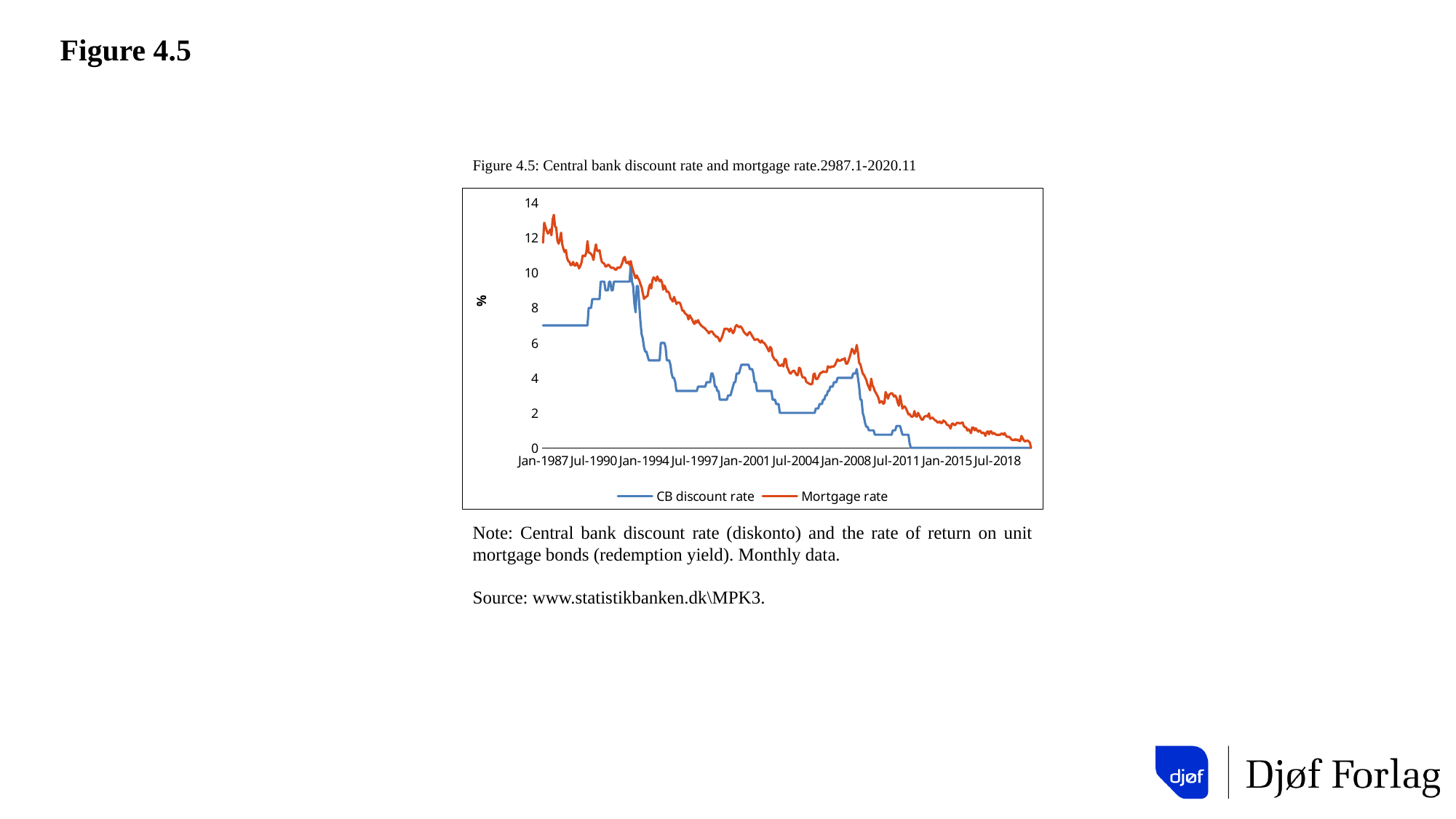
Overall, do the CB discount rate values rise or fall from Jan-1987 to Jul-2018? fall At Jan-1987, which series has the higher value, CB discount rate or Mortgage rate? Mortgage rate What is the label on the vertical axis? % What kind of chart is shown on the slide? line chart Is the CB discount rate at Jan-1987 greater or less than 6? greater What are the two series named in the legend? CB discount rate and Mortgage rate Which series reaches the highest value shown on the chart? Mortgage rate Is the CB discount rate at Jul-2018 greater or less than 2? less How many series does the legend list? 2 Is the Mortgage rate at Jul-2018 greater or less than 2? less Overall, do the Mortgage rate values rise or fall from Jan-1987 to Jul-2018? fall